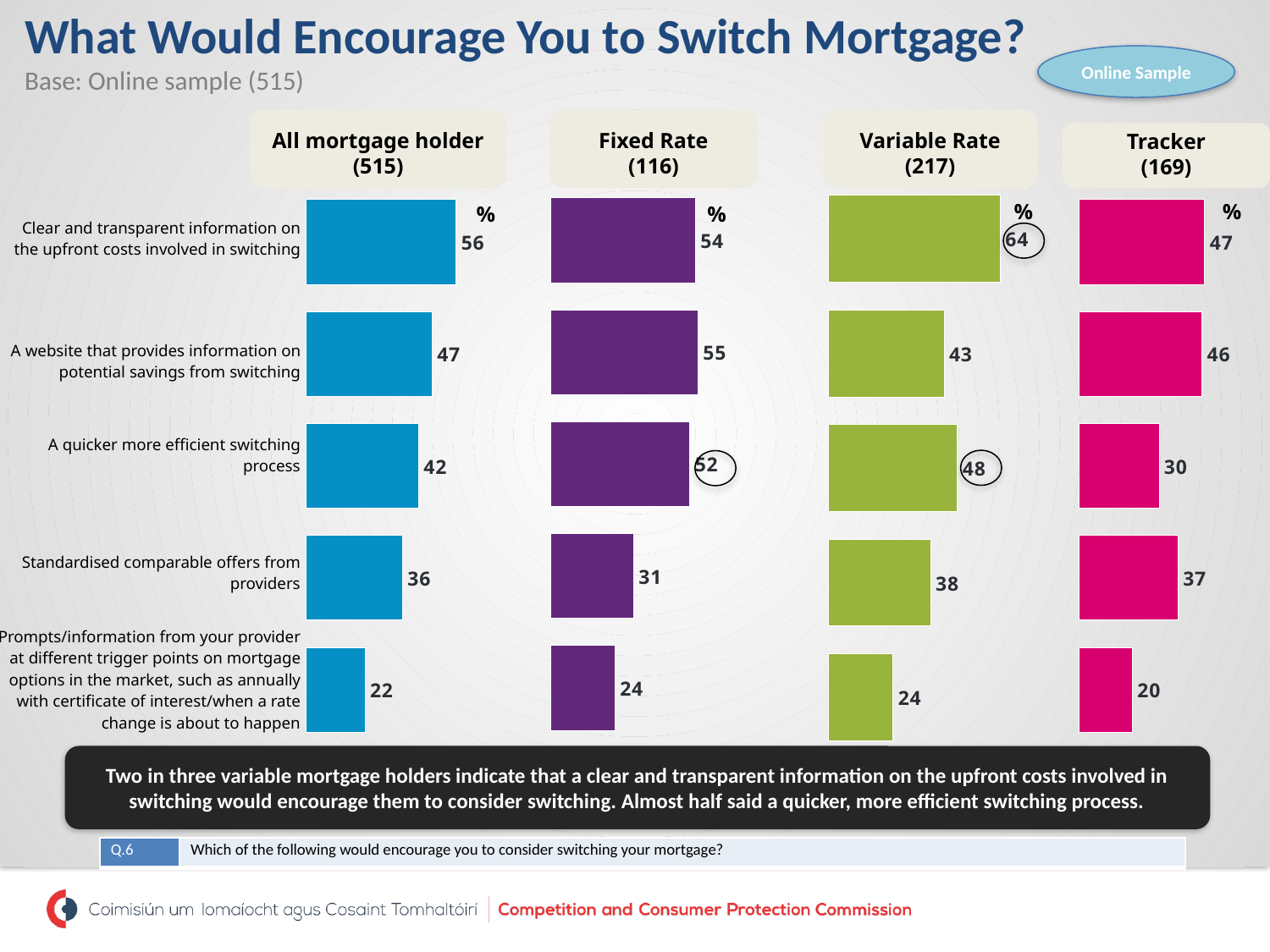
How many categories are shown in the All mortgage holder (515) chart? 5 In the Variable Rate (217) chart, what is the difference between 'Clear and transparent information on the upfront costs involved in switching' and 'A website that provides information on potential savings from switching'? 21 In the All mortgage holder (515) chart, what is the value for 'Clear and transparent information on the upfront costs involved in switching'? 56 In the Fixed Rate (116) chart, what is the difference between 'A quicker more efficient switching process' and 'Standardised comparable offers from providers'? 21 What colour are the bars in the Variable Rate (217) chart? Green In the Tracker (169) chart, what is the value for 'Standardised comparable offers from providers'? 37 In the All mortgage holder (515) chart, do the values rise or fall from the top category to the bottom category? Fall In the Tracker (169) chart, which is larger: 'A quicker more efficient switching process' or 'Standardised comparable offers from providers'? Standardised comparable offers from providers What type of chart is used for the Fixed Rate (116) data? Bar chart In the Variable Rate (217) chart, what is the value for 'A quicker more efficient switching process'? 48 In the Variable Rate (217) chart, which category has the lowest value? Prompts/information from your provider at different trigger points on mortgage options in the market, such as annually with certificate of interest/when a rate change is about to happen In the Fixed Rate (116) chart, which category has the highest value? A website that provides information on potential savings from switching